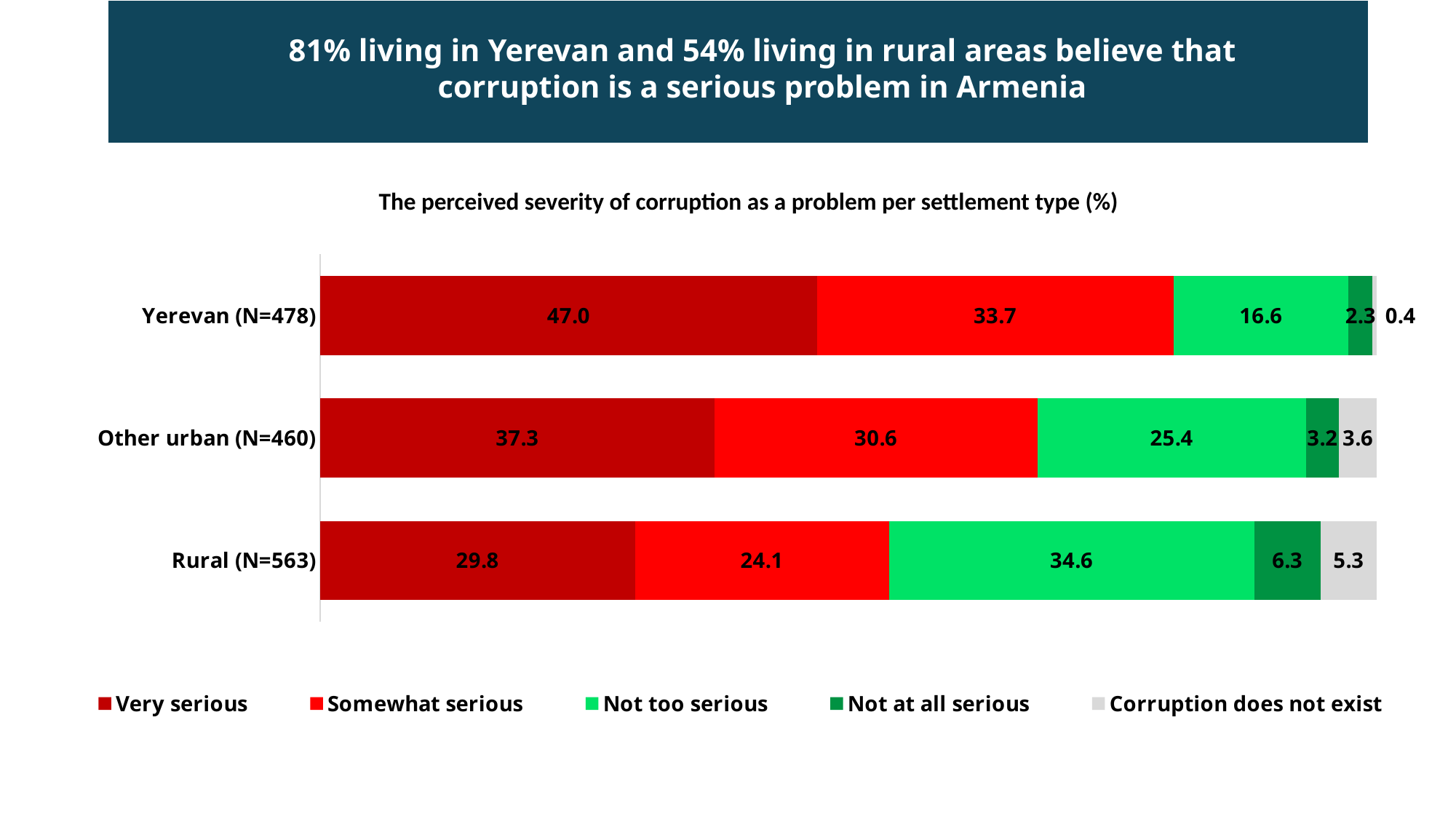
What is the title of the chart? The perceived severity of corruption as a problem per settlement type (%) Which settlement type has the lowest 'Somewhat serious' value? Rural (N=563) How many settlement types are shown in the chart? 3 What is the 'Not too serious' value for Rural (N=563)? 34.6 Which is larger: the 'Not too serious' value for Other urban (N=460) or for Yerevan (N=478)? Other urban (N=460) What is the 'Corruption does not exist' value for Other urban (N=460)? 3.6 What is the difference between the 'Very serious' values for Yerevan (N=478) and Rural (N=563)? 17.2 Which settlement type has the highest 'Very serious' value? Yerevan (N=478) What kind of chart is shown on the slide? Stacked bar chart What is the combined 'Very serious' and 'Somewhat serious' value for Rural (N=563)? 53.9 How many series does the legend list? 5 What is the 'Very serious' value for Yerevan (N=478)? 47.0